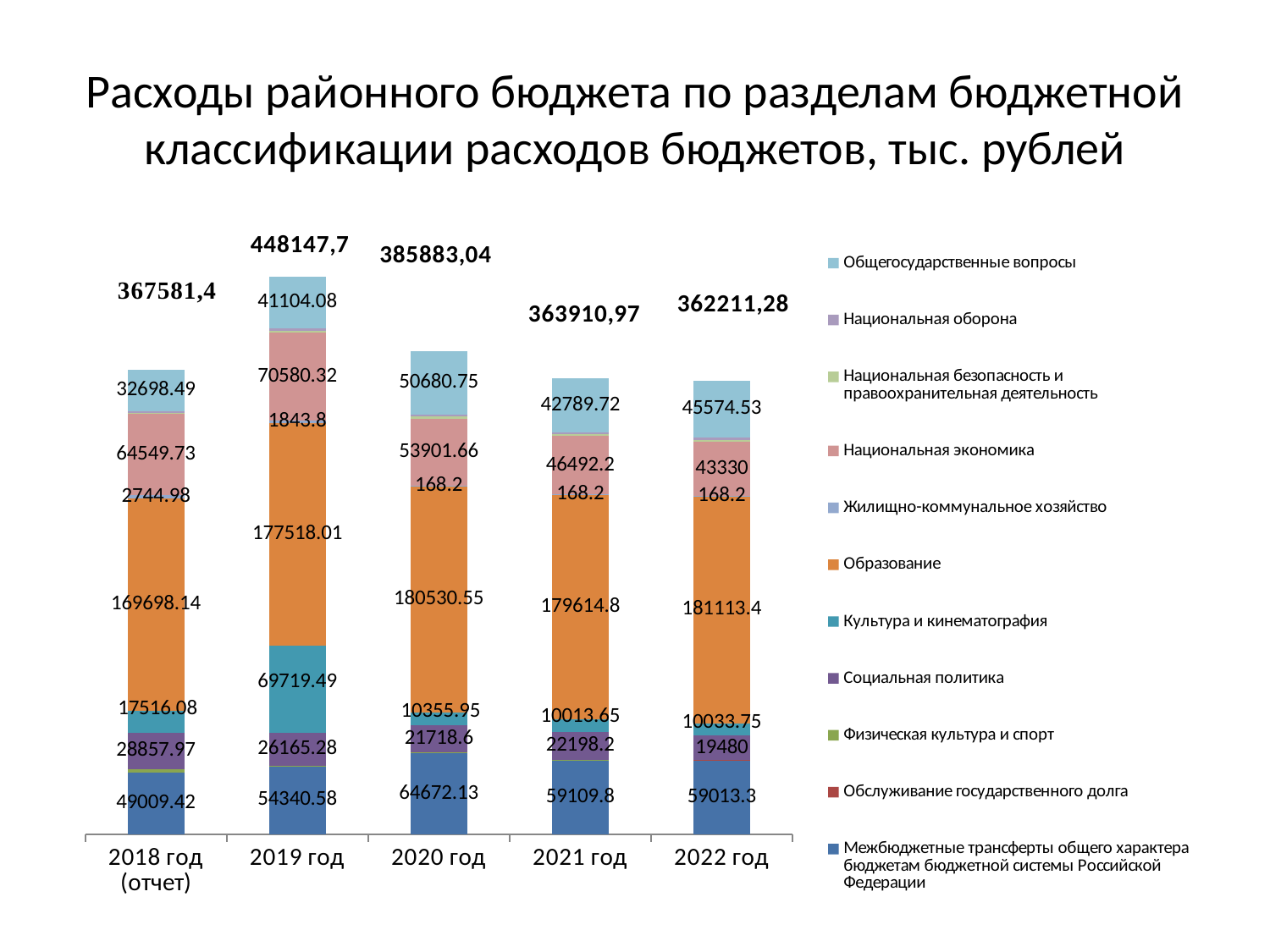
What is the value for Образование in 2020 год? 180530.55 What is the value for Межбюджетные трансферты общего характера бюджетам бюджетной системы Российской Федерации in 2018 год (отчет)? 49009.42 Which is larger: the value for Культура и кинематография in 2019 год or in 2020 год? 2019 год What is the value for Общегосударственные вопросы in 2022 год? 45574.53 How many series does the legend list? 11 What is the title of the chart? Расходы районного бюджета по разделам бюджетной классификации расходов бюджетов, тыс. рублей Which year has the highest total expenditure? 2019 год How many years (categories) are shown on the x axis? 5 What is the total of the stacked bar for 2019 год? 448147,7 What kind of chart is shown on the slide? Stacked bar chart What is the difference between the Образование values for 2022 год and 2021 год? 1498.6 Which year has the lowest total expenditure? 2022 год